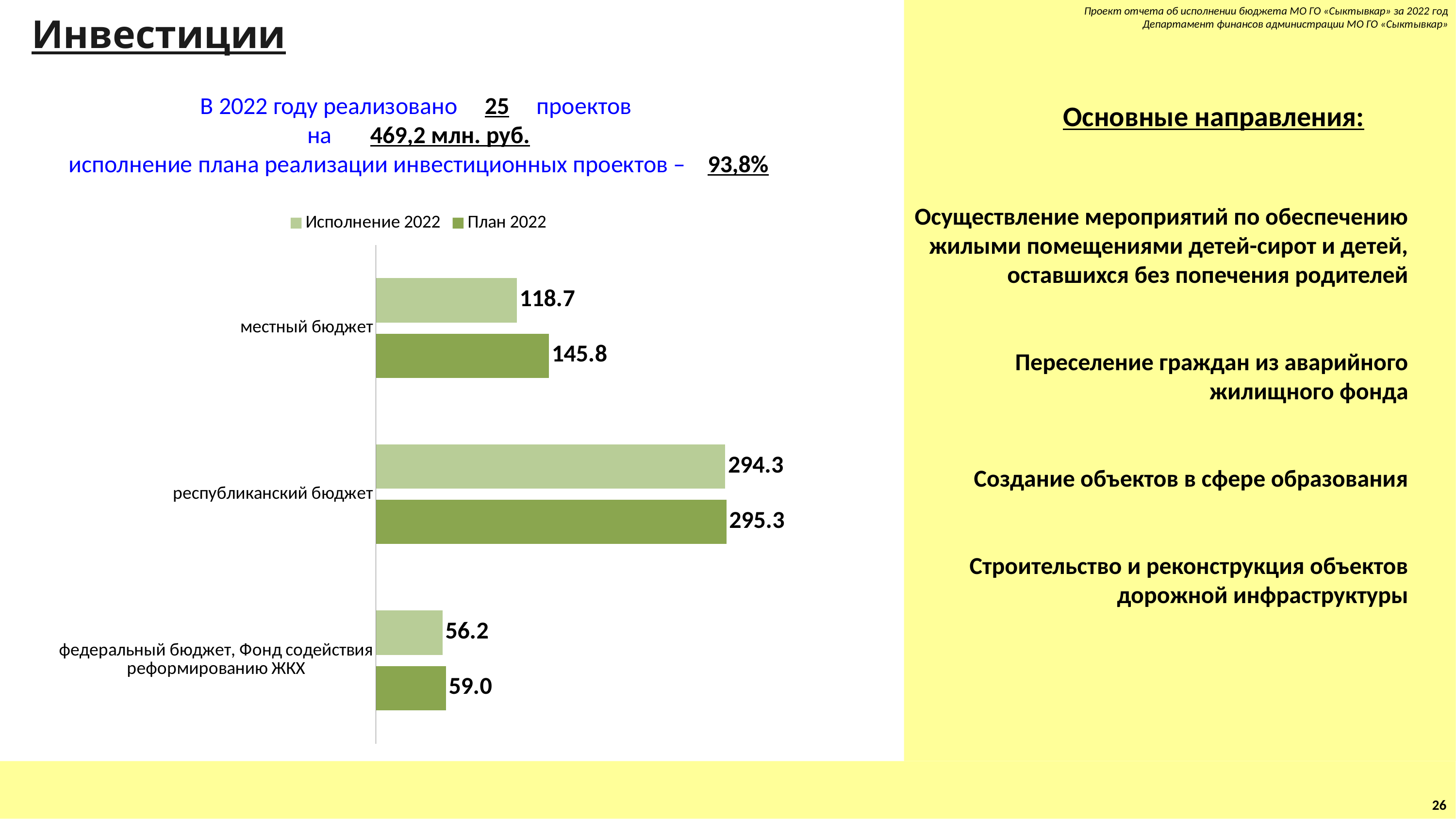
What is the value of Исполнение 2022 for местный бюджет? 118.7 How many categories are shown on the chart? 3 Which category has the lowest План 2022 value? федеральный бюджет, Фонд содействия реформированию ЖКХ What is the value of План 2022 for местный бюджет? 145.8 What is the value of План 2022 for республиканский бюджет? 295.3 Which category has the highest Исполнение 2022 value? республиканский бюджет How many series does the legend list? 2 Which is larger for местный бюджет: Исполнение 2022 or План 2022? План 2022 What is the difference between План 2022 and Исполнение 2022 for федеральный бюджет, Фонд содействия реформированию ЖКХ? 2.8 What is the value of Исполнение 2022 for федеральный бюджет, Фонд содействия реформированию ЖКХ? 56.2 What is the difference between План 2022 and Исполнение 2022 for местный бюджет? 27.1 What kind of chart is shown on the slide? bar chart